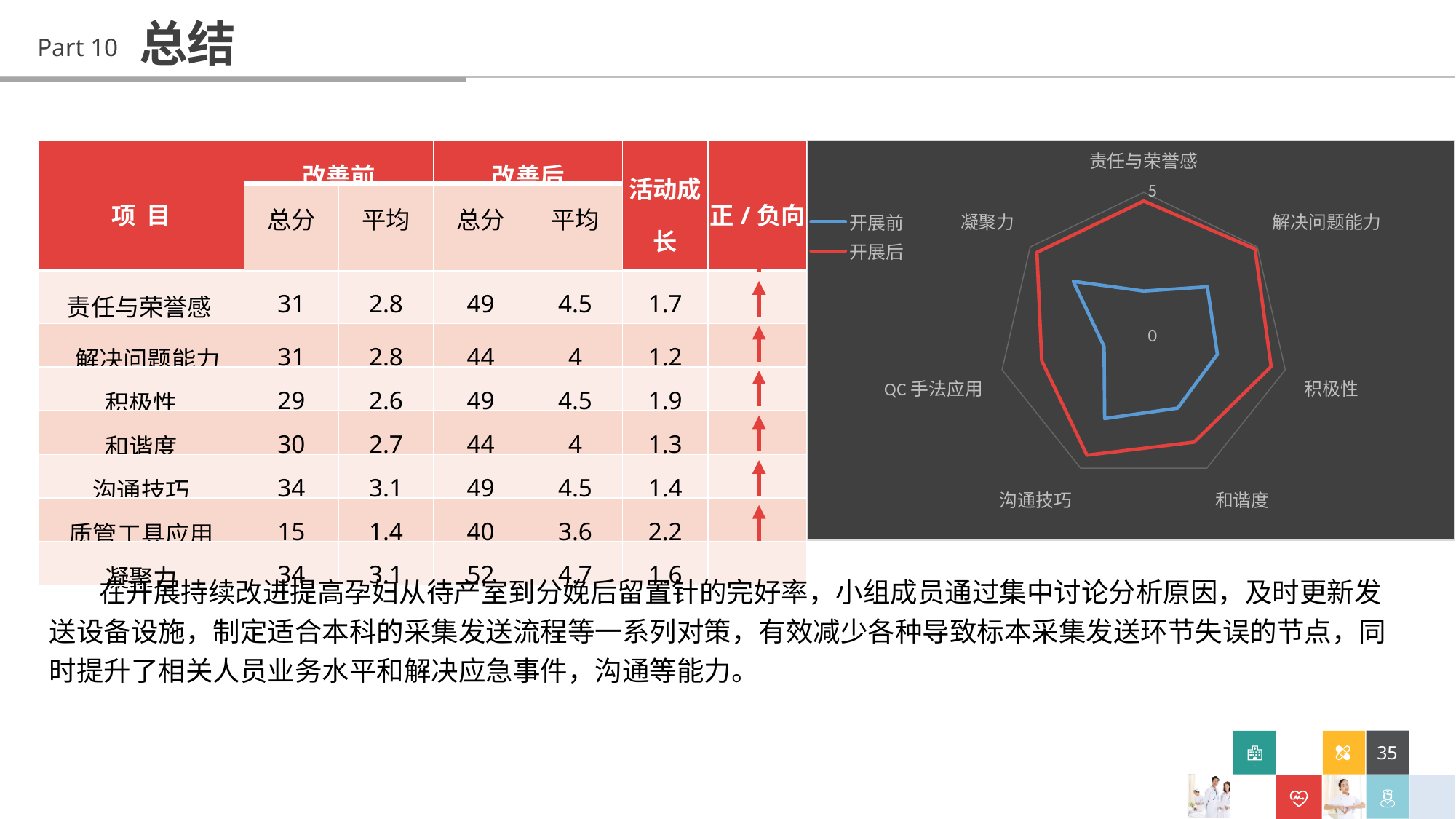
On the radar chart, which series has the larger value for 积极性, 开展前 or 开展后? 开展后 How many series does the legend of the radar chart list? 2 On the radar chart, for which category is the 开展前 value lowest? QC 手法应用 On the radar chart, which series has the larger value for 责任与荣誉感, 开展前 or 开展后? 开展后 Which series is drawn in red on the radar chart? 开展后 How many axes (categories) does the radar chart have? 7 Which series is drawn in blue on the radar chart? 开展前 On the radar chart, which series has the larger value for QC 手法应用, 开展前 or 开展后? 开展后 What kind of chart is shown on the right side of the slide? radar chart What is the maximum value shown on the radar chart's axis scale? 5 On the radar chart, is the 开展前 value for 凝聚力 greater or less than 5? less